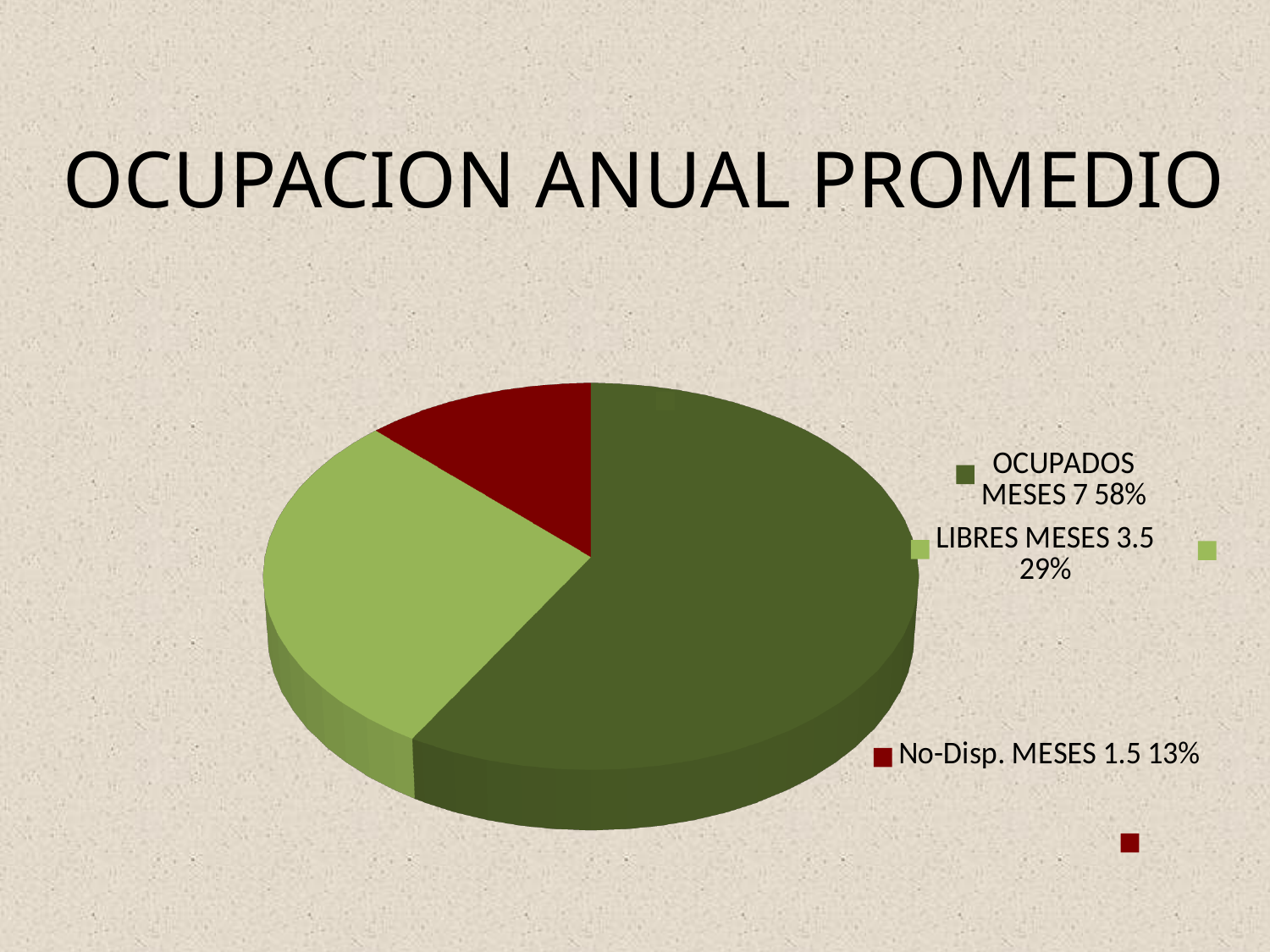
How many months (MESES) are shown for No-Disp.? 1.5 How many months (MESES) are shown for LIBRES? 3.5 What percentage share does the OCUPADOS slice have? 58% What is the title of the chart? OCUPACION ANUAL PROMEDIO How many slices does the pie chart have? 3 How many months (MESES) are shown for OCUPADOS? 7 What kind of chart is shown on the slide? Pie chart What percentage share does the No-Disp. slice have? 13% What is the difference in percentage points between the OCUPADOS and LIBRES slices? 29% What percentage share does the LIBRES slice have? 29% Which category has the largest slice of the pie? OCUPADOS Which category has the smallest slice of the pie? No-Disp.